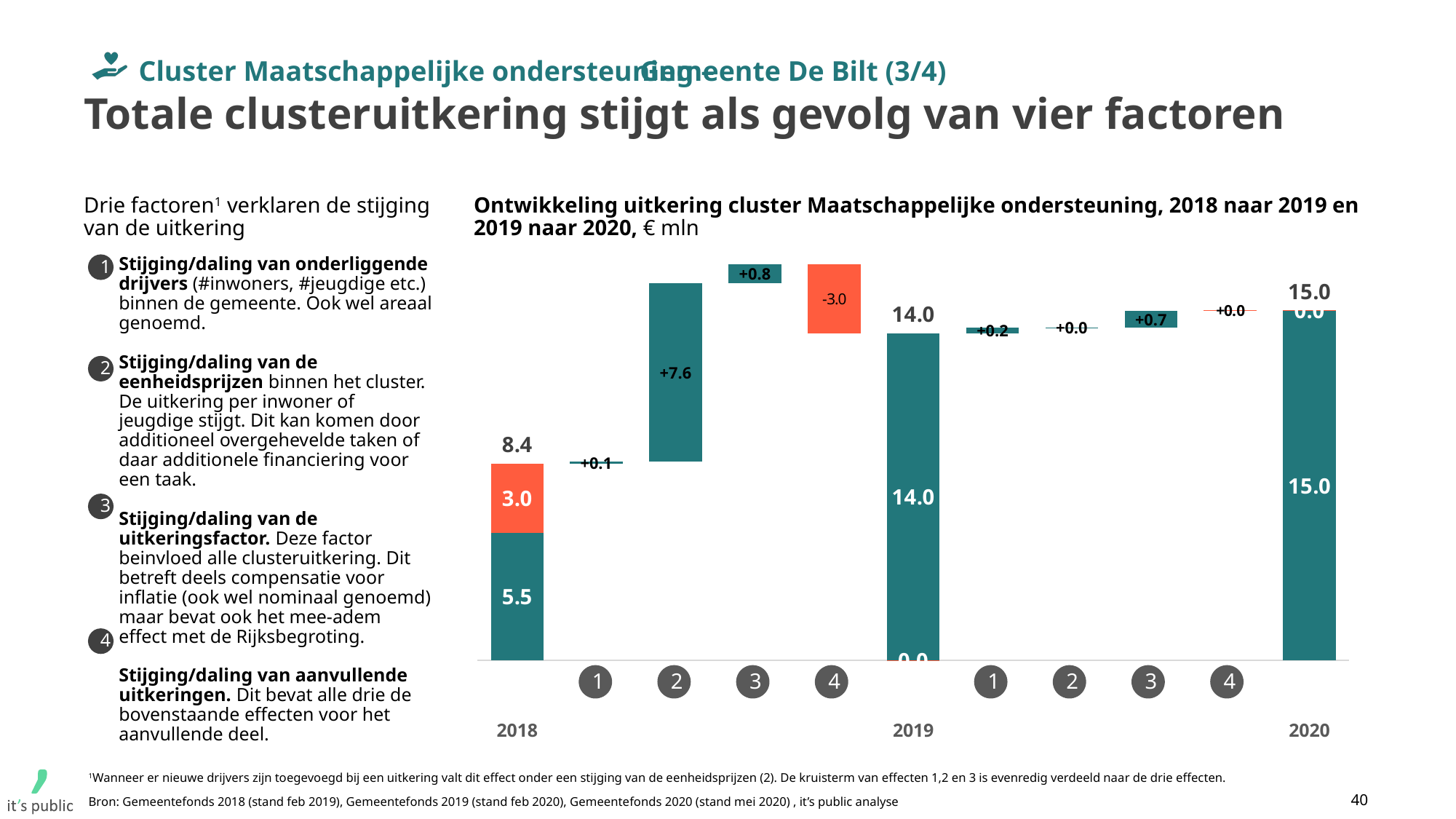
What is the total uitkering shown for 2020 in the chart? 15.0 By how much does the total uitkering increase from 2018 to 2019? 5.6 Which factor has the largest effect in the step from 2018 to 2019? Factor 2 (+7.6) Does the total uitkering rise or fall from 2018 to 2020? Rises What is the total uitkering shown for 2019 in the chart? 14.0 What is the value of the orange segment of the 2018 bar? 3.0 What is the total uitkering shown for 2018 in the chart? 8.4 Is the effect of factor 1 larger in the step 2018 to 2019 or in the step 2019 to 2020? 2019 to 2020 (+0.2) What is the effect of factor 4 in the step from 2018 to 2019? -3.0 What is the effect of factor 2 in the step from 2018 to 2019? +7.6 What is the effect of factor 3 in the step from 2019 to 2020? +0.7 In what unit are the values in the chart expressed? € mln